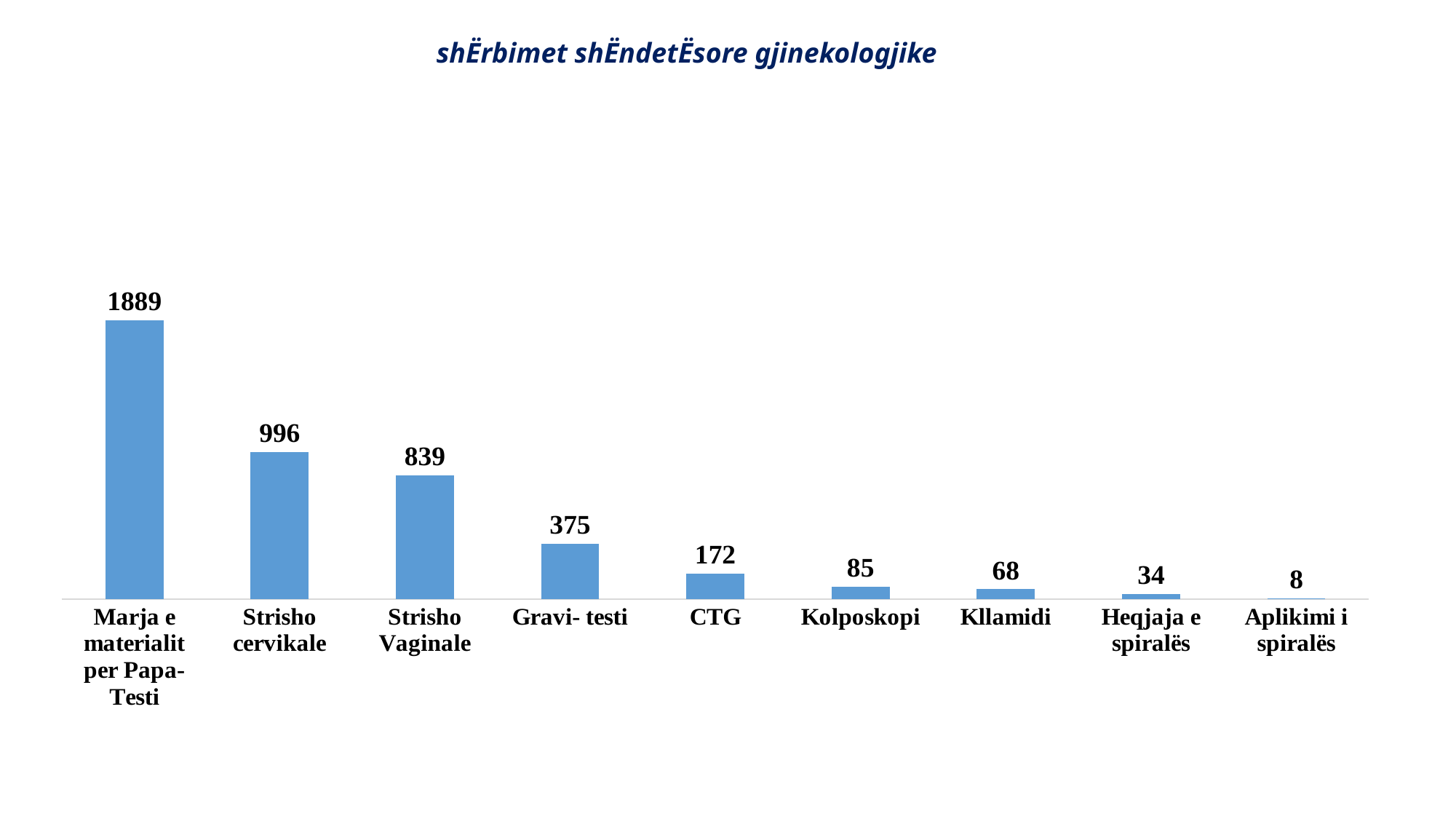
What is the value for Kolposkopi? 85 What is the value for Aplikimi i spiralës? 8 What is the difference between the values for Gravi- testi and CTG? 203 Which is larger, the value for Kllamidi or the value for Heqjaja e spiralës? Kllamidi What is the difference between the values for Strisho cervikale and Strisho Vaginale? 157 What kind of chart is shown on the slide? Bar chart How many categories are shown on the chart? 9 Which category has the highest value? Marja e materialit per Papa-Testi What is the value for CTG? 172 Which category has the lowest value? Aplikimi i spiralës What is the value for Strisho cervikale? 996 Do the values rise or fall from left to right along the x axis? Fall